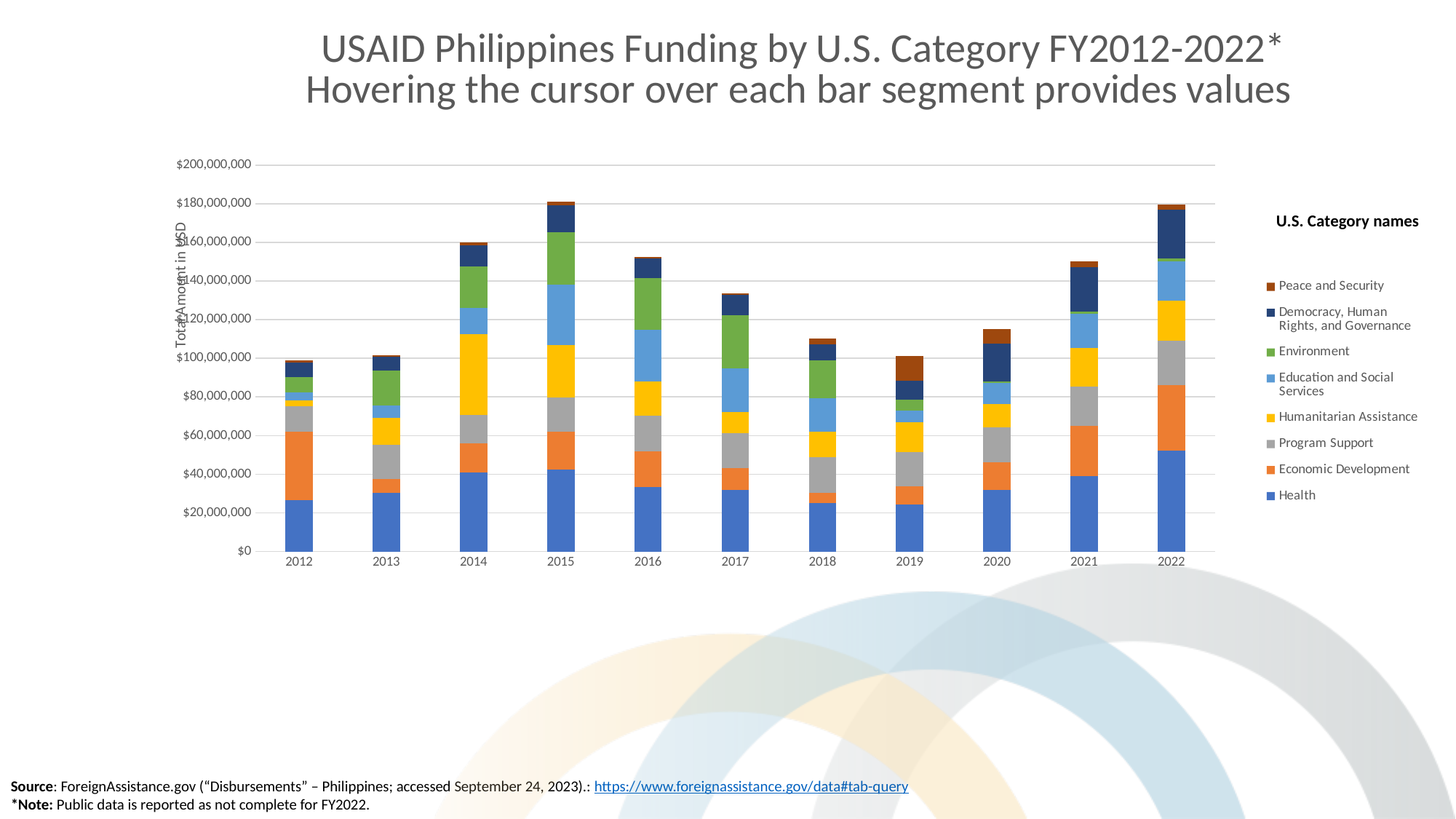
Is the total funding for 2014 greater or less than $140,000,000? greater Is the Health segment for 2022 greater or less than $40,000,000? greater Is the total funding for 2018 greater or less than $120,000,000? less Do the total funding amounts rise or fall from 2015 to 2019? fall What is the title of the chart's legend? U.S. Category names How many U.S. categories does the chart legend list? 8 How many fiscal years are shown along the x axis of the chart? 11 What kind of chart is shown on the slide? Stacked bar chart Which year has the larger total funding, 2021 or 2019? 2021 Which year has the larger total funding, 2014 or 2018? 2014 Do the total funding amounts rise or fall from 2019 to 2022? rise